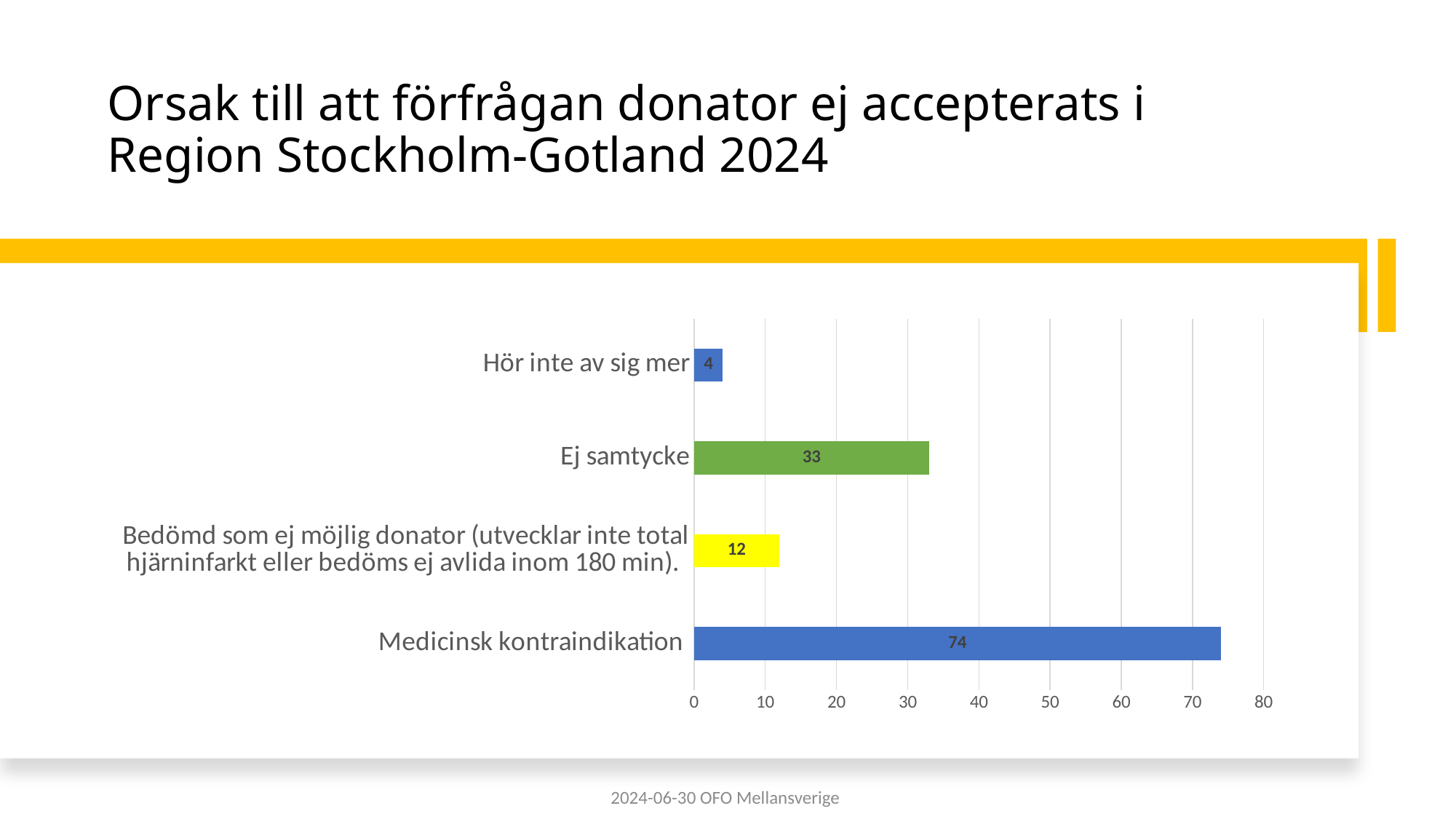
What is the value for Ej samtycke? 33 Which is larger, the value for Ej samtycke or the value for Bedömd som ej möjlig donator? Ej samtycke What is the title of the slide containing the chart? Orsak till att förfrågan donator ej accepterats i Region Stockholm-Gotland 2024 What is the value for the category 'Bedömd som ej möjlig donator (utvecklar inte total hjärninfarkt eller bedöms ej avlida inom 180 min).'? 12 How many categories are shown in the chart? 4 Is the value for Medicinsk kontraindikation greater or less than 70? greater Which category has the lowest value? Hör inte av sig mer Which category has the highest value? Medicinsk kontraindikation What is the value for Medicinsk kontraindikation? 74 What is the value for Hör inte av sig mer? 4 What kind of chart is shown on the slide? Bar chart What is the difference between the values for Medicinsk kontraindikation and Ej samtycke? 41